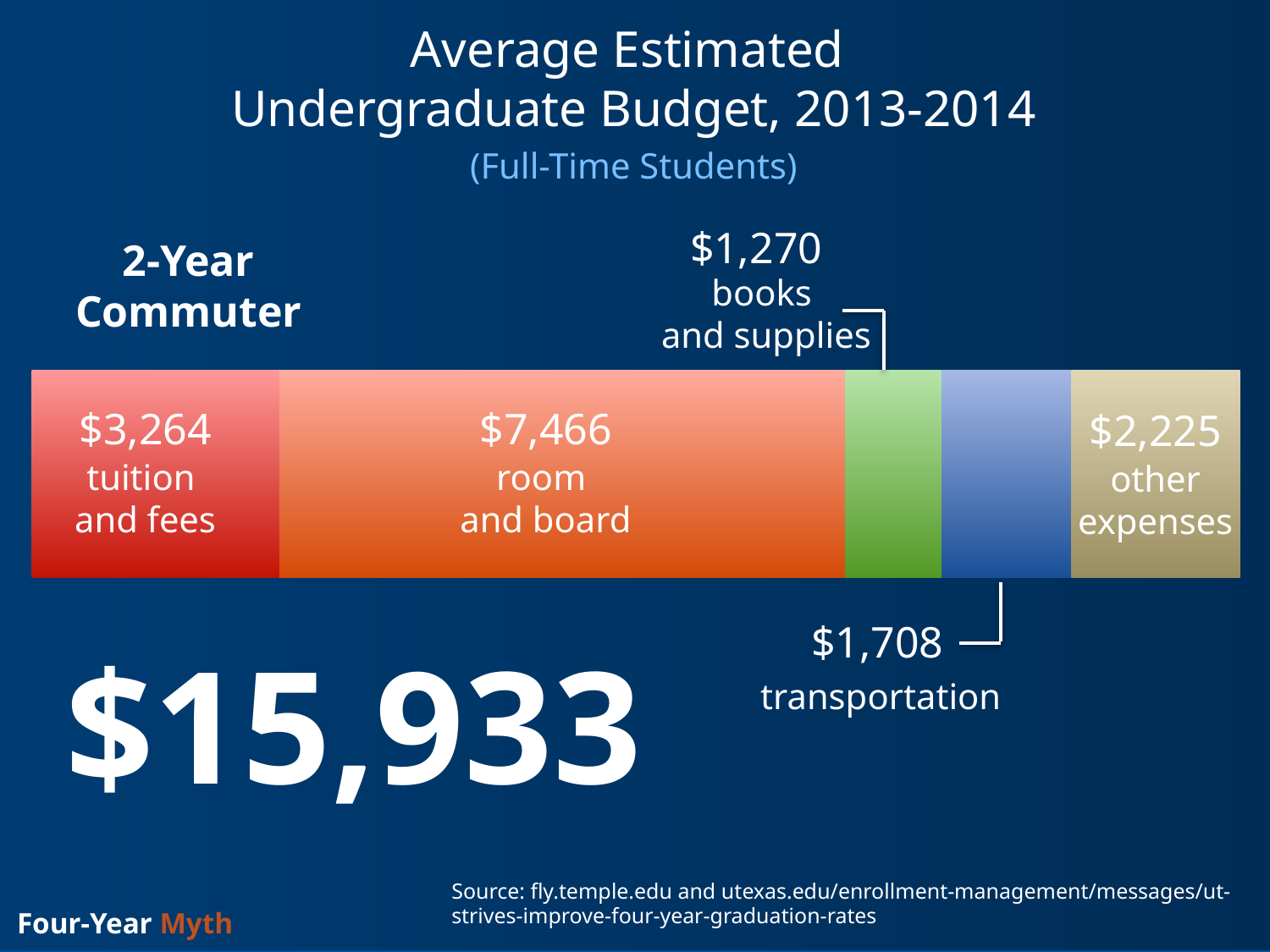
What is the value for tuition and fees in the 2-Year Commuter budget bar? $3,264 What is the value for room and board in the 2-Year Commuter budget bar? $7,466 What is the difference between other expenses and transportation in the 2-Year Commuter budget? $517 Which is larger in the 2-Year Commuter budget, other expenses or transportation? other expenses What is the total of the 2-Year Commuter budget bar? $15,933 What is the value for books and supplies in the 2-Year Commuter budget bar? $1,270 Which category has the largest value in the 2-Year Commuter budget bar? room and board Which category has the smallest value in the 2-Year Commuter budget bar? books and supplies What kind of chart is shown on the slide? stacked bar chart What is the difference between room and board and tuition and fees in the 2-Year Commuter budget? $4,202 What is the value for transportation in the 2-Year Commuter budget bar? $1,708 How many expense categories make up the 2-Year Commuter budget bar? 5